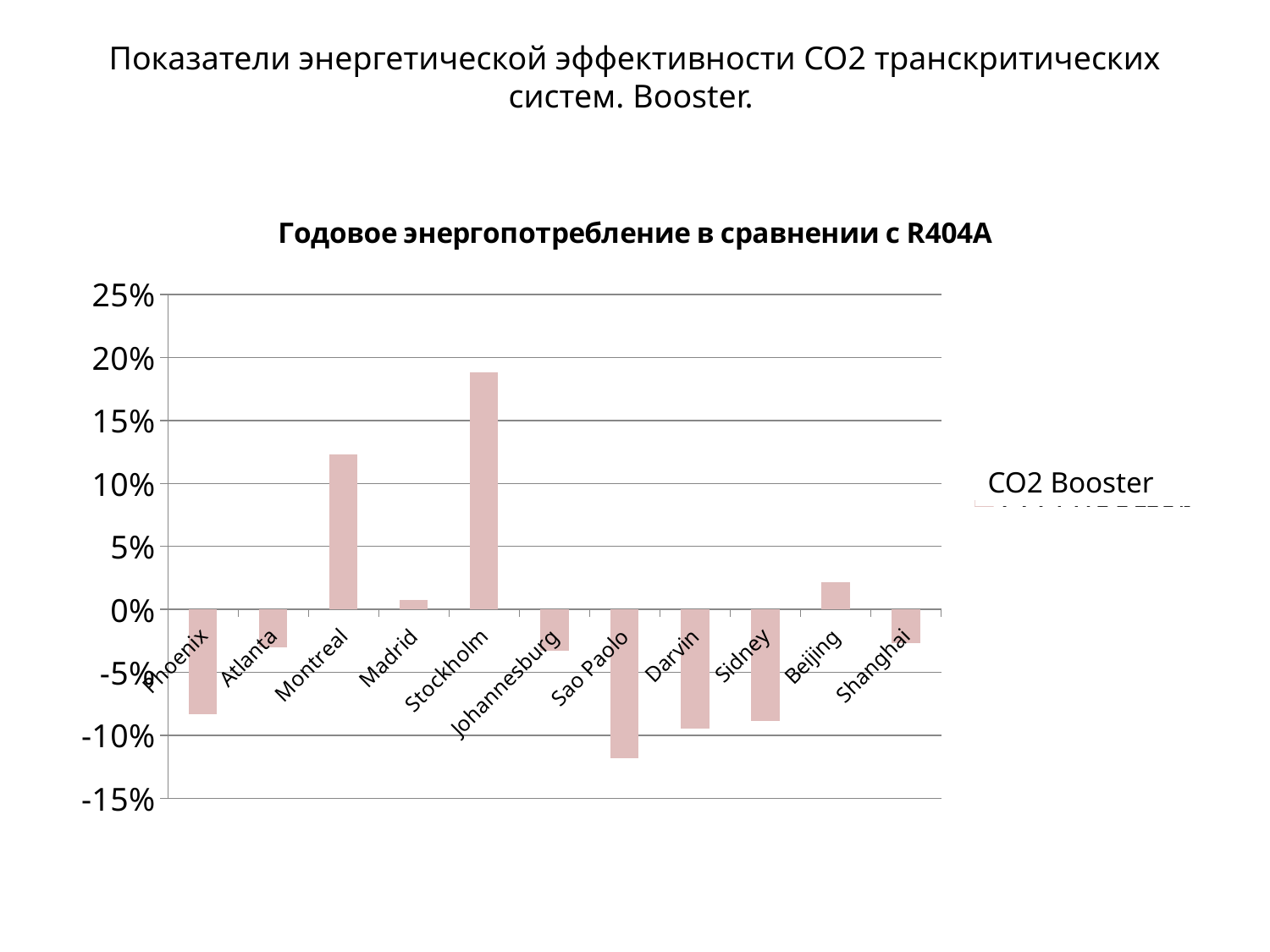
Is the value for Phoenix greater or less than -5%? less Which city has the lowest value? Sao Paolo What is the name of the series shown in the legend? CO2 Booster How many series does the legend list? 1 What is the title of the chart? Годовое энергопотребление в сравнении с R404A Which is larger, the value for Montreal or the value for Stockholm? Stockholm Is the value for Stockholm greater or less than 15%? greater Which city has the highest value? Stockholm How many cities are shown on the x axis? 11 What kind of chart is shown on the slide? bar chart Is the value for Sao Paolo greater or less than -10%? less